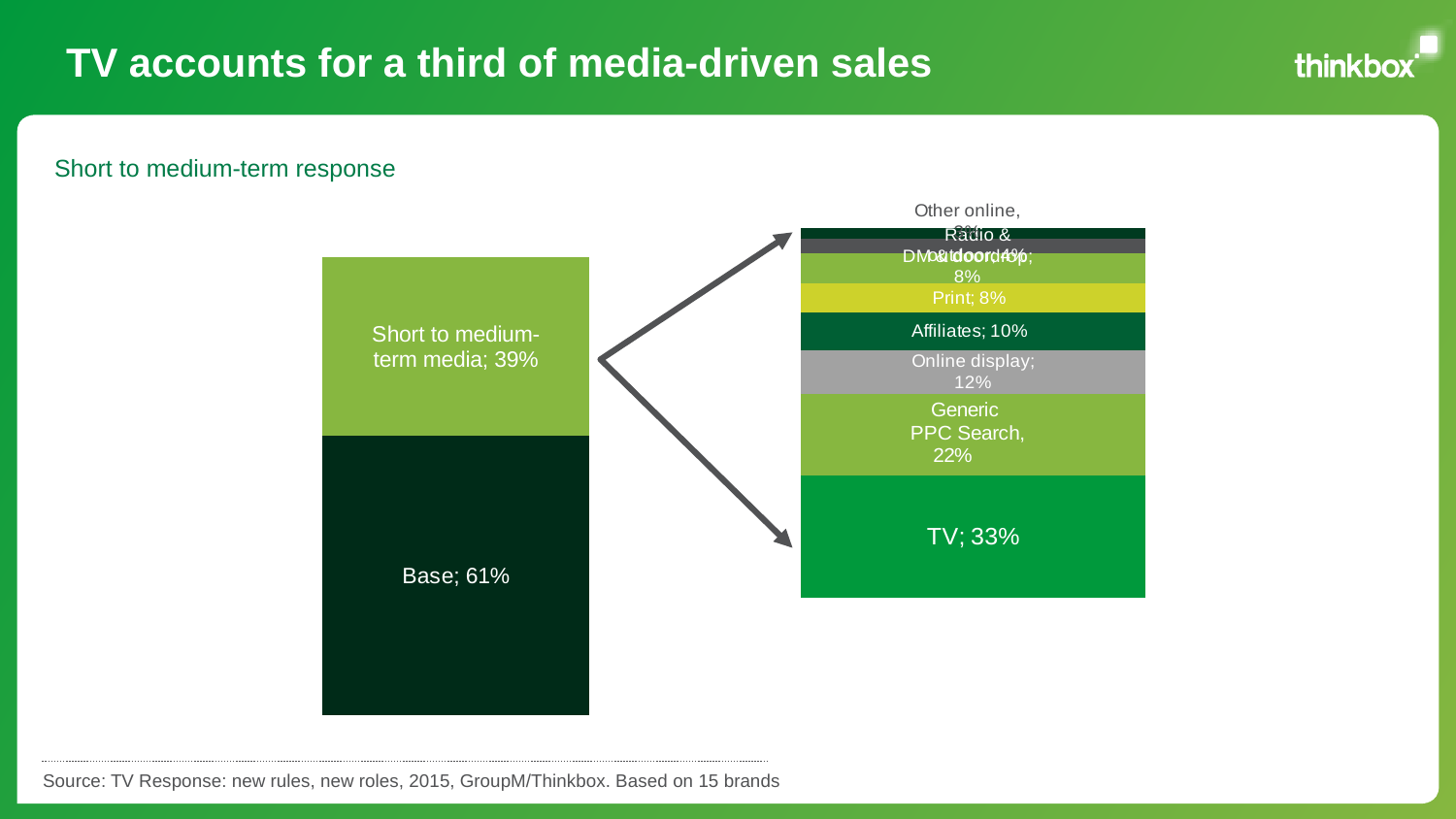
In the left stacked bar, what is the total of the Base and Short to medium-term media segments? 100% In the right stacked bar, which is larger, Online display or Affiliates? Online display In the right stacked bar, what is the value for Affiliates? 10% In the right stacked bar, what is the value for TV? 33% In the left stacked bar, what is the value for Short to medium-term media? 39% In the right stacked bar, what is the value for Online display? 12% In the right stacked bar, what is the value for Print? 8% In the right stacked bar, what is the value for Generic PPC Search? 22% What kind of chart is used on this slide? Stacked bar chart In the right stacked bar, what is the difference between the TV value and the Generic PPC Search value? 11 percentage points In the left stacked bar, what is the value for Base? 61% In the right stacked bar, which segment has the largest value? TV